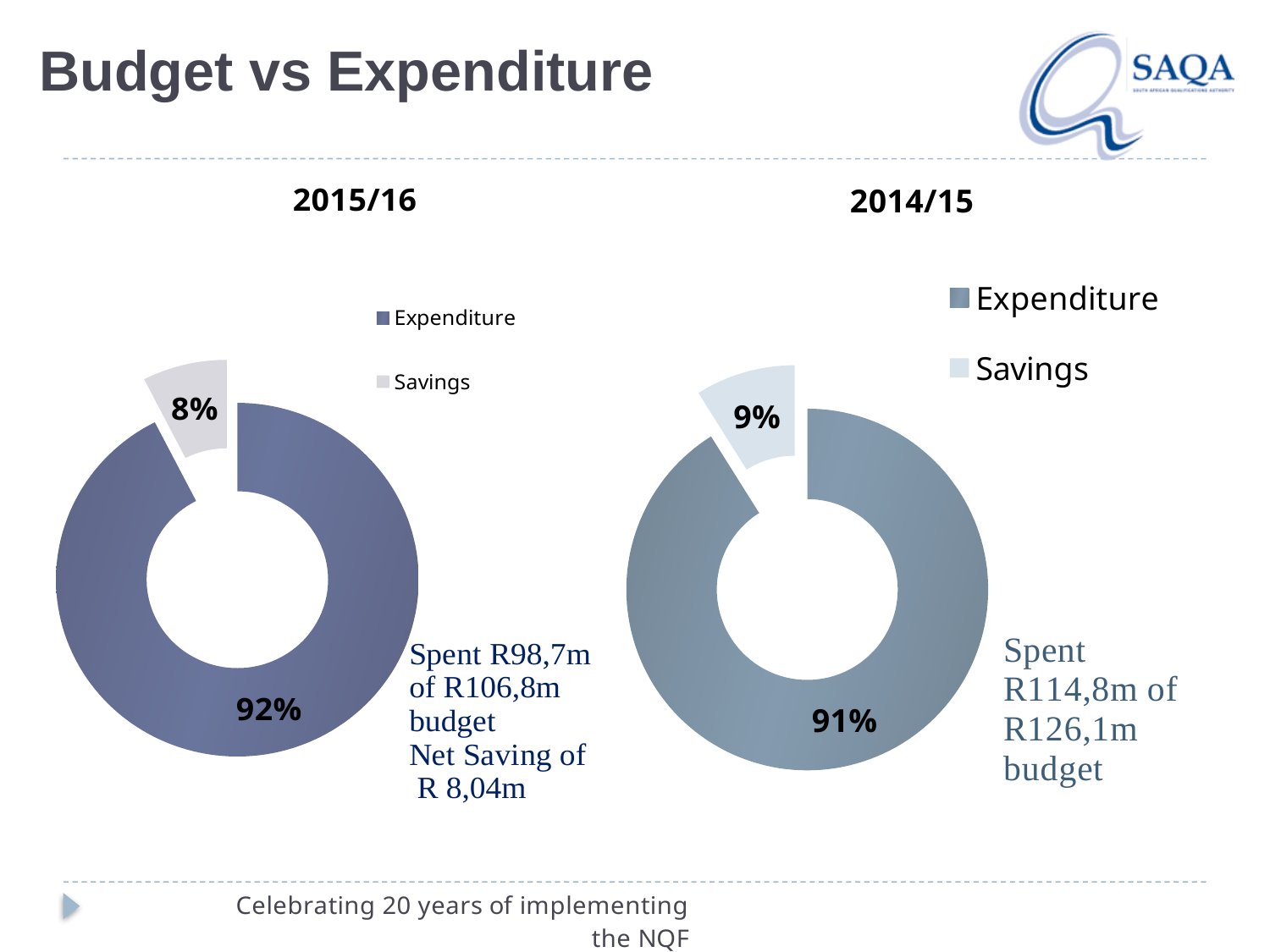
What is the difference between the Expenditure share in 2015/16 and the Expenditure share in 2014/15? 1% In the 2014/15 chart, what share of the budget is Expenditure? 91% How many slices does the 2014/15 chart have? 2 Which is larger: the Savings share in 2015/16 or the Savings share in 2014/15? 2014/15 In the 2015/16 chart, what share of the budget is Savings? 8% In the 2014/15 chart, which slice is the smallest? Savings How many entries does the legend of the 2015/16 chart list? 2 What is the title of the slide containing the two charts? Budget vs Expenditure What kind of chart is used for 2015/16? Doughnut (pie) chart In the 2015/16 chart, which slice is the largest? Expenditure In the 2015/16 chart, what share of the budget is Expenditure? 92%